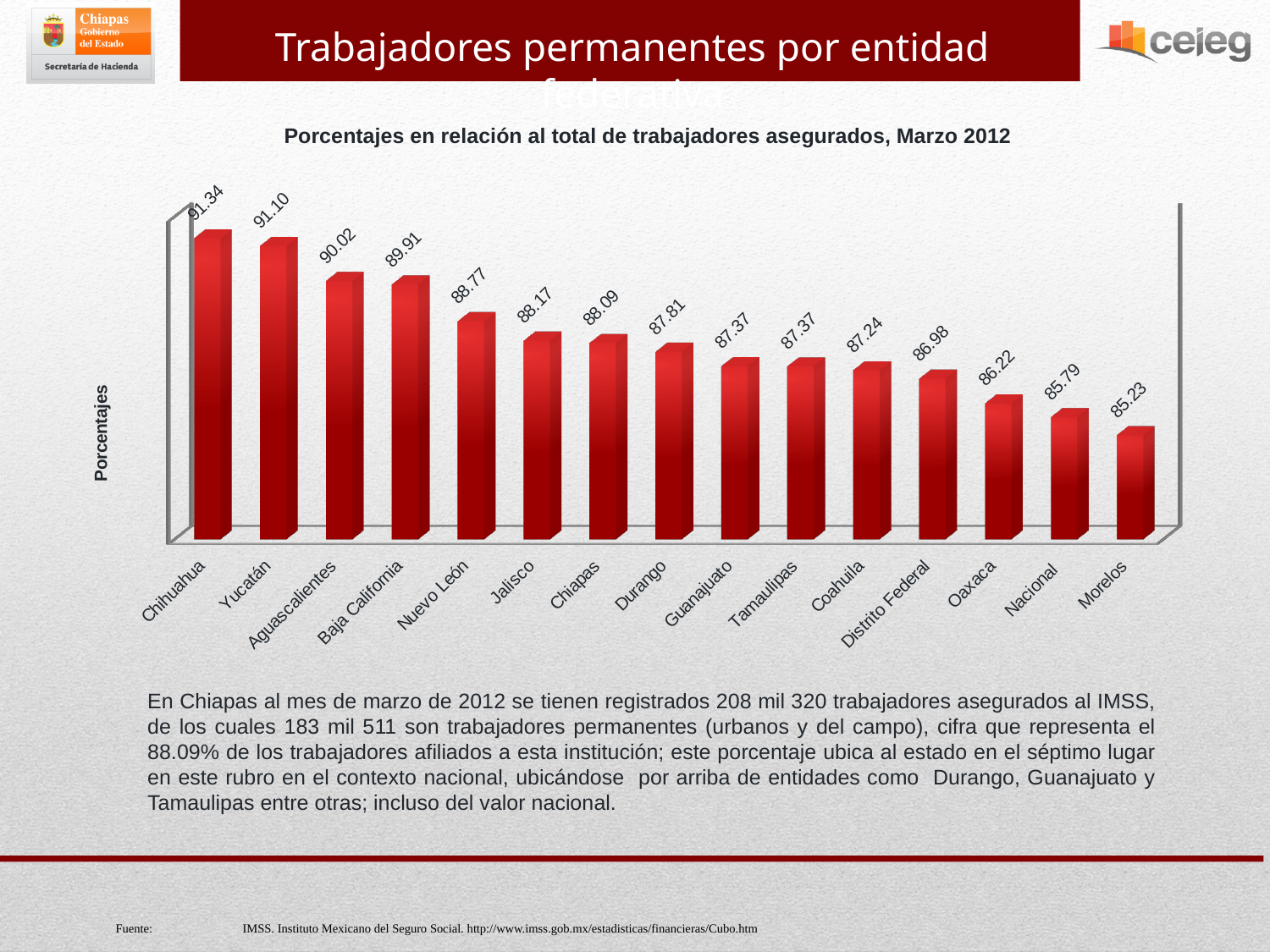
What is the value for Nuevo León? 88.77 What is the difference between the values for Chiapas and Nacional? 2.30 What is the value for Nacional? 85.79 What is the difference between the values for Chihuahua and Morelos? 6.11 Which is larger, the value for Oaxaca or the value for Distrito Federal? Distrito Federal Which is larger, the value for Yucatán or the value for Aguascalientes? Yucatán What kind of chart is shown? Bar chart Which entity has the lowest value? Morelos Which entity has the highest value? Chihuahua How many entities are shown on the chart? 15 Do the values rise or fall from left to right along the x axis? Fall What is the value for Chiapas? 88.09